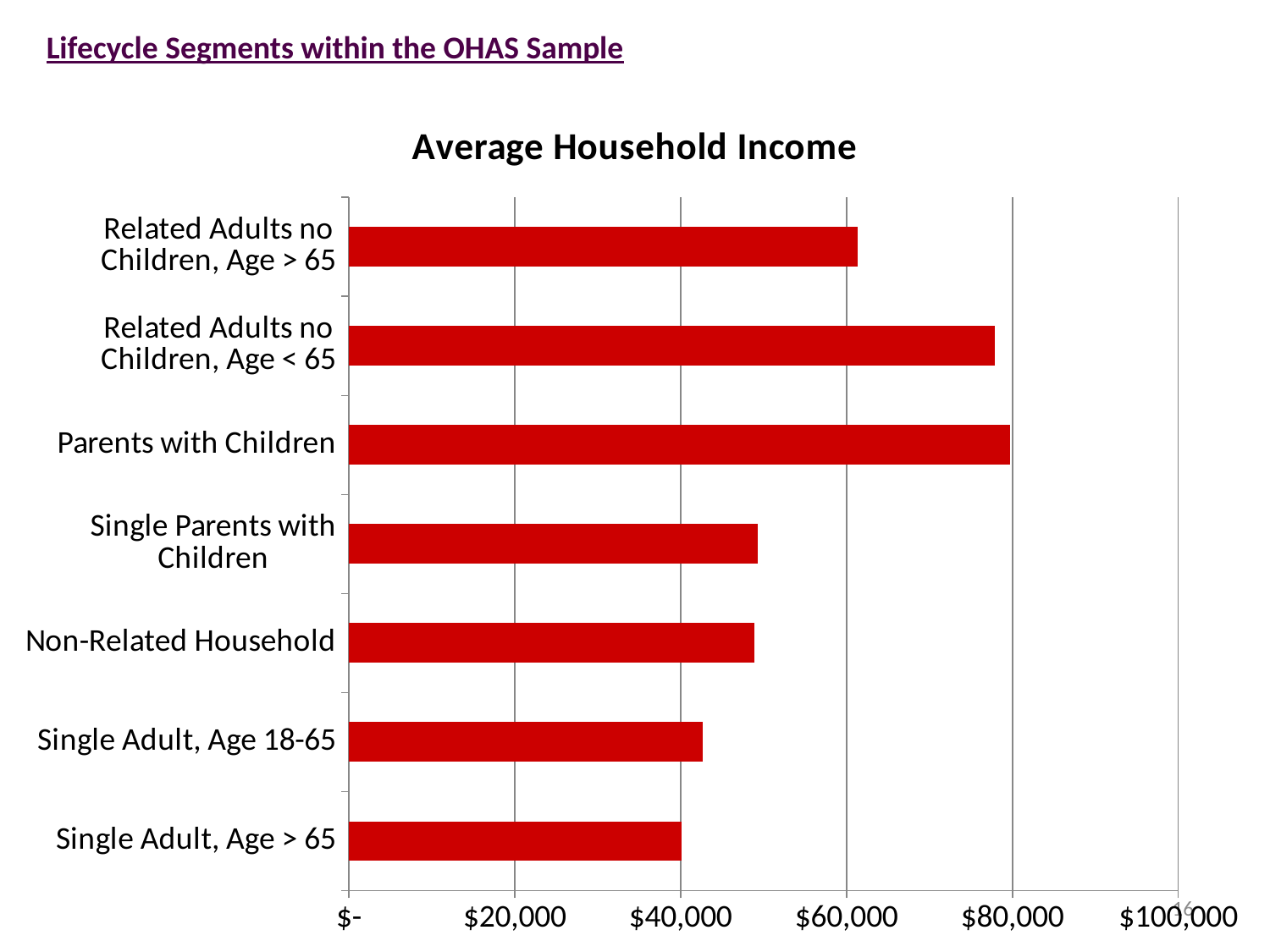
How many lifecycle segments (categories) are plotted in the chart? 7 Is the average household income for Related Adults no Children, Age > 65 greater or less than $80,000? less What kind of chart is shown on the slide? Bar chart What is the title of the chart? Average Household Income Which lifecycle segment has the highest average household income? Parents with Children Is the average household income for Non-Related Household greater or less than $60,000? less Is the average household income for Single Parents with Children greater or less than $40,000? greater Which lifecycle segment has the lowest average household income? Single Adult, Age > 65 Which has a higher average household income: Related Adults no Children, Age < 65 or Related Adults no Children, Age > 65? Related Adults no Children, Age < 65 Which has a higher average household income: Single Parents with Children or Single Adult, Age 18-65? Single Parents with Children